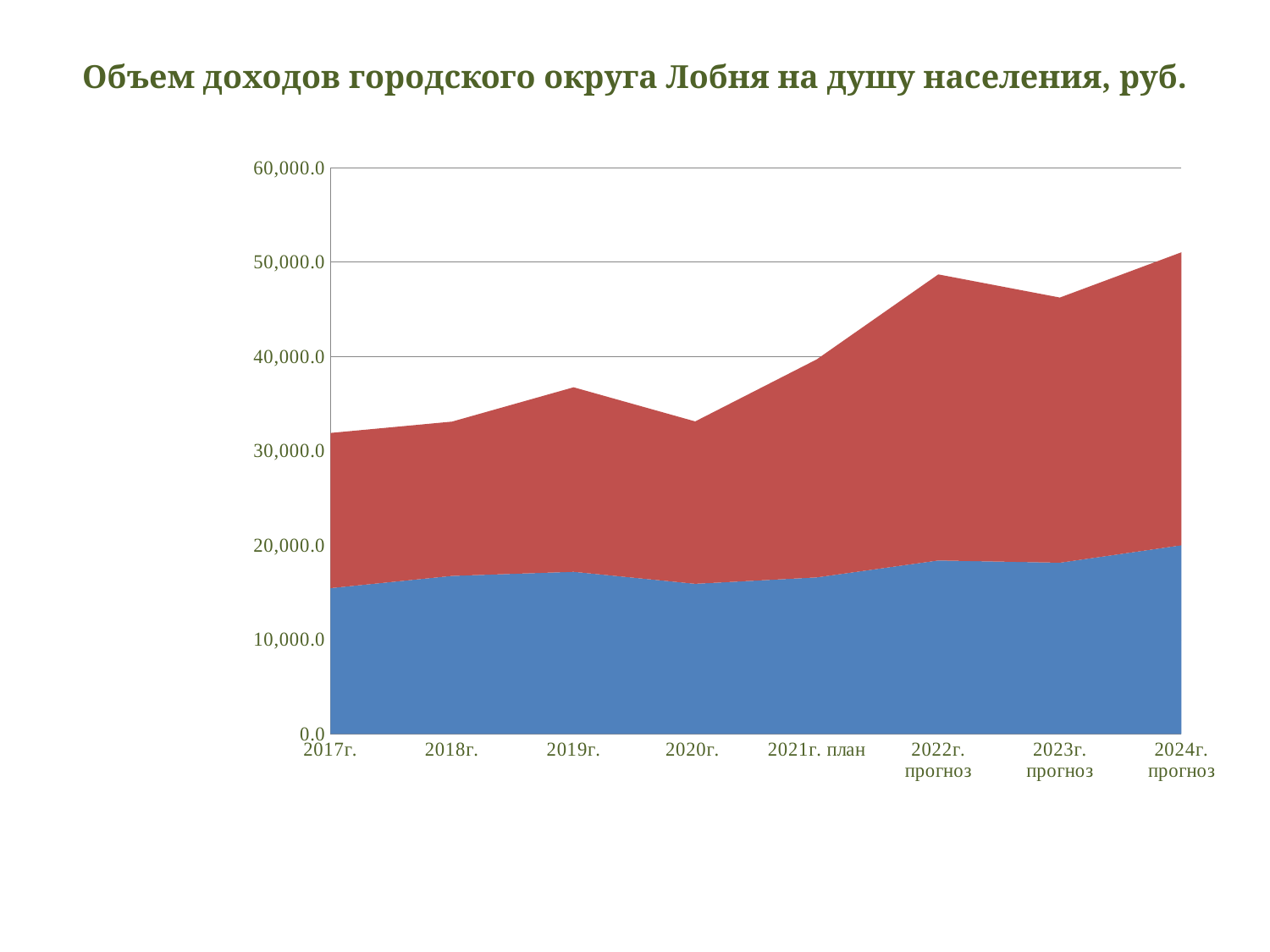
What kind of chart is shown on the slide? area chart Which category has the highest total value? 2024г. прогноз Which has the larger total value, 2022г. прогноз or 2023г. прогноз? 2022г. прогноз Is the total value for 2019г. greater or less than 40,000.0? less How many categories (years) are shown along the x axis? 8 Is the total value for 2022г. прогноз greater or less than 50,000.0? less Do the total values generally rise or fall from 2017г. to 2024г. прогноз? rise Is the total value for 2017г. greater or less than 30,000.0? greater What is the title of the chart? Объем доходов городского округа Лобня на душу населения, руб. Which has the larger total value, 2019г. or 2020г.? 2019г.